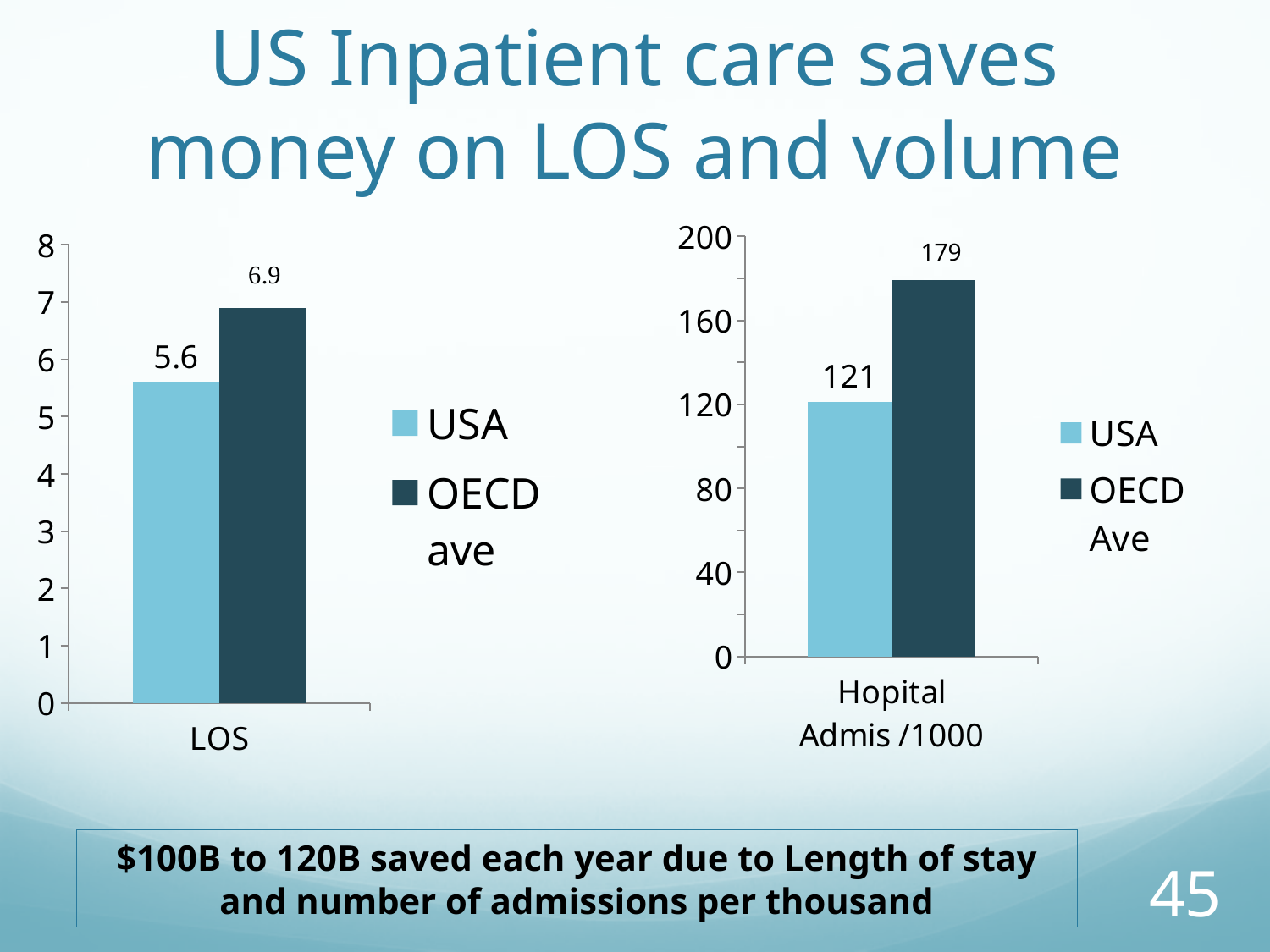
In the right chart (Hopital Admis /1000), what is the difference between the OECD Ave and USA values? 58 In the left chart (LOS), which series has the higher value? OECD ave In the right chart (Hopital Admis /1000), which series has the lower value? USA In the right chart (Hopital Admis /1000), what is the value for OECD Ave? 179 In the left chart (LOS), what is the value for OECD ave? 6.9 How many series does the legend of the left chart (LOS) list? 2 In the right chart (Hopital Admis /1000), is the value for USA greater or less than 160? less In the left chart (LOS), what is the value for USA? 5.6 What kind of chart is the right chart (Hopital Admis /1000)? bar chart In the left chart (LOS), what is the difference between the OECD ave and USA values? 1.3 In the right chart (Hopital Admis /1000), what colour is the USA bar? light blue In the right chart (Hopital Admis /1000), what is the value for USA? 121